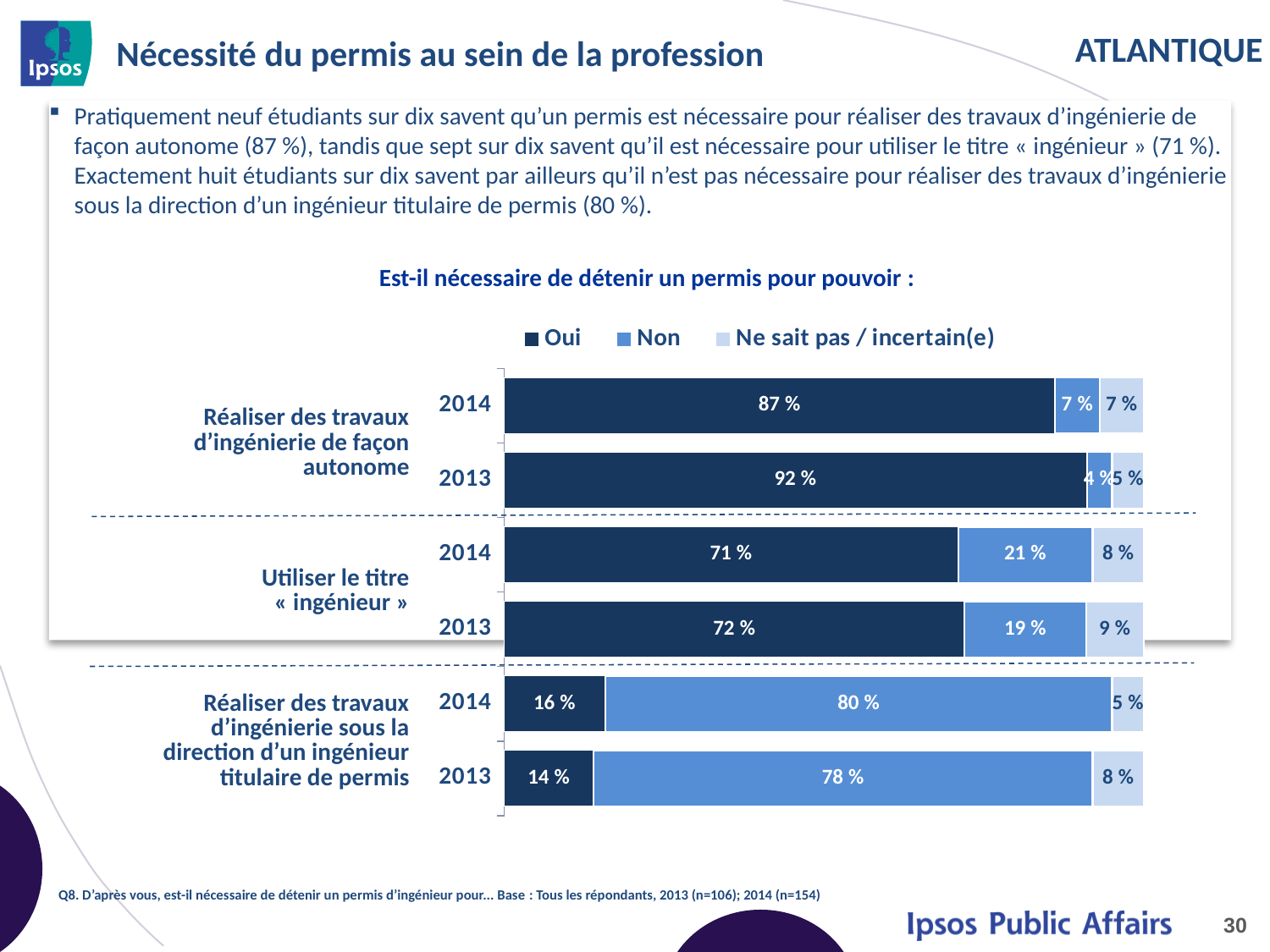
Which bar has the highest 'Oui' value? Réaliser des travaux d'ingénierie de façon autonome, 2013 What is the 'Oui' value for 'Réaliser des travaux d'ingénierie de façon autonome' in 2014? 87 % What is the 'Non' value for 'Utiliser le titre « ingénieur »' in 2014? 21 % Which bar has the lowest 'Oui' value? Réaliser des travaux d'ingénierie sous la direction d'un ingénieur titulaire de permis, 2013 How many bars are plotted in the chart? 6 Which legend entry is shown in the darkest blue colour? Oui For 'Réaliser des travaux d'ingénierie sous la direction d'un ingénieur titulaire de permis', is the 'Non' value larger in 2014 or 2013? 2014 What is the 'Ne sait pas / incertain(e)' value for 'Utiliser le titre « ingénieur »' in 2013? 9 % How many series does the chart legend list? 3 What is the 'Non' value for 'Réaliser des travaux d'ingénierie sous la direction d'un ingénieur titulaire de permis' in 2013? 78 % What is the difference between the 'Oui' values for 'Réaliser des travaux d'ingénierie de façon autonome' in 2013 and 2014? 5 % What kind of chart is shown on the slide? stacked bar chart